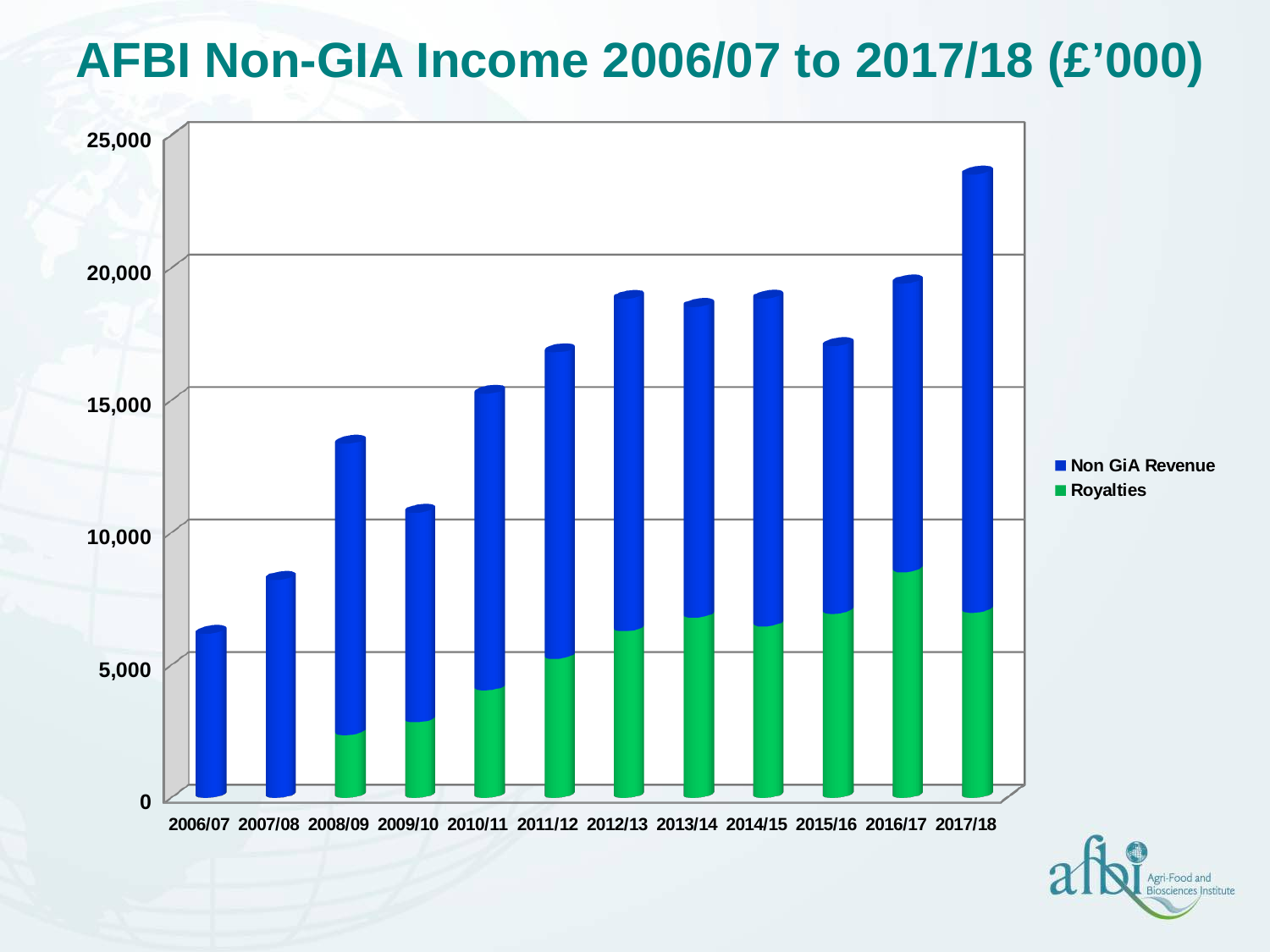
Which year has the lowest total Non-GIA income? 2006/07 Is the total value for 2008/09 greater or less than 15,000? less Which series is shown in green in the legend? Royalties How many years (categories) are shown on the x axis? 12 What kind of chart is shown on the slide? Stacked bar chart Is the total value for 2006/07 greater or less than 5,000? greater Is the total value for 2017/18 greater or less than 20,000? greater Do the total values generally rise or fall from 2006/07 to 2017/18? rise Which year has the highest total Non-GIA income? 2017/18 Which year has the larger total income, 2015/16 or 2016/17? 2016/17 How many series does the legend list? 2